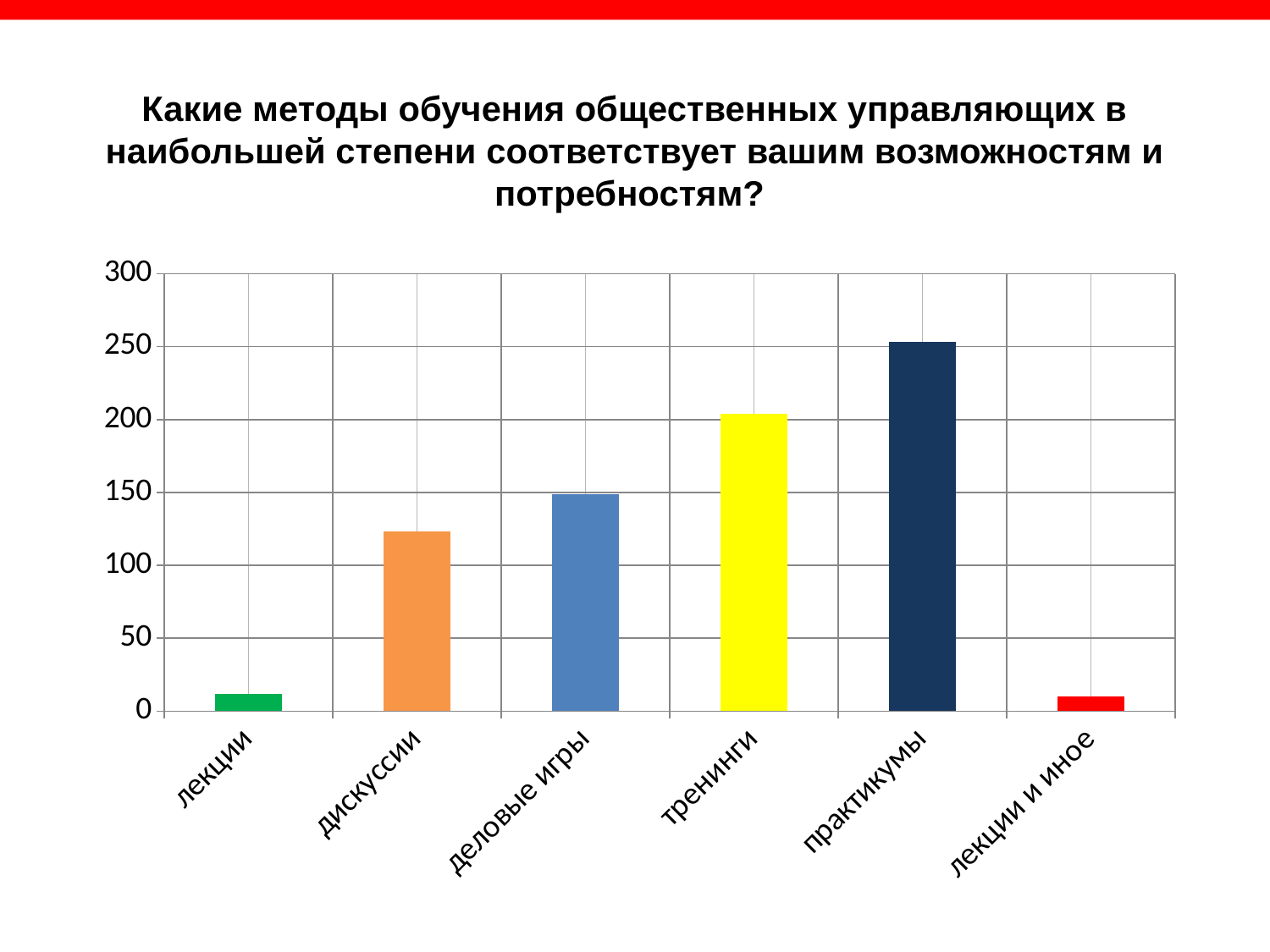
What colour is the bar for практикумы? dark blue Is the value for лекции и иное greater or less than 50? less Is the value for тренинги greater or less than 250? less Is the value for лекции greater or less than 50? less Which is larger, the value for дискуссии or the value for практикумы? практикумы Which category has the highest value in the chart? практикумы Which is larger, the value for тренинги or the value for деловые игры? тренинги What kind of chart is shown on the slide? bar chart How many categories are shown on the x axis of the chart? 6